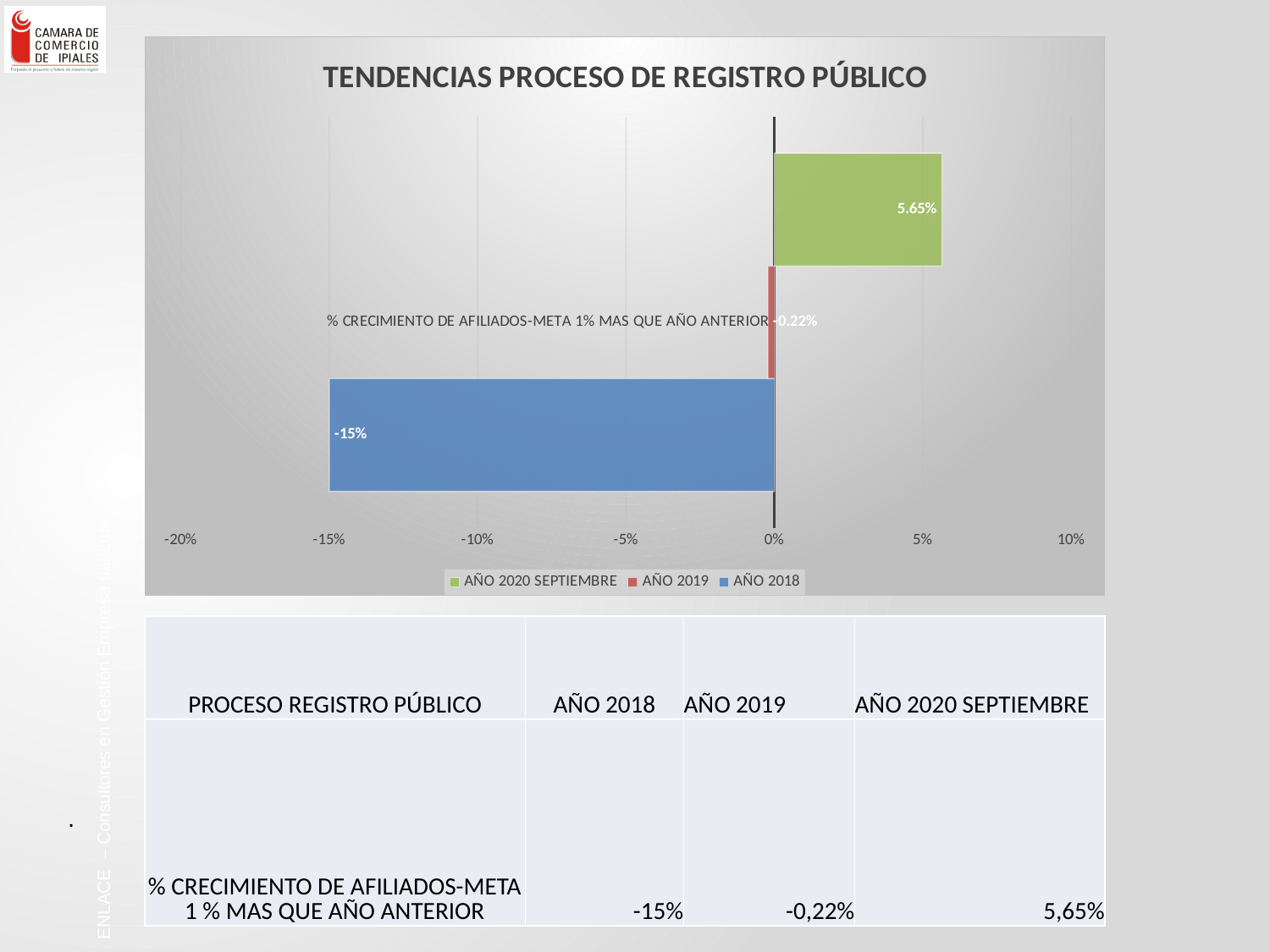
What is the value for AÑO 2018 in the chart? -15% What is the title of the chart? TENDENCIAS PROCESO DE REGISTRO PÚBLICO Is the value for AÑO 2018 greater or less than -10%? less What is the value for AÑO 2019 in the chart? -0.22% How many series does the legend list? 3 Which series has the highest value in the chart? AÑO 2020 SEPTIEMBRE What is the value for AÑO 2020 SEPTIEMBRE in the chart? 5.65% What kind of chart is shown on the slide? Bar chart Which is larger, the value for AÑO 2019 or the value for AÑO 2018? AÑO 2019 Which series has the lowest value in the chart? AÑO 2018 What is the difference between the AÑO 2020 SEPTIEMBRE value and the AÑO 2019 value? 5.87% Is the value for AÑO 2020 SEPTIEMBRE greater or less than 5%? greater